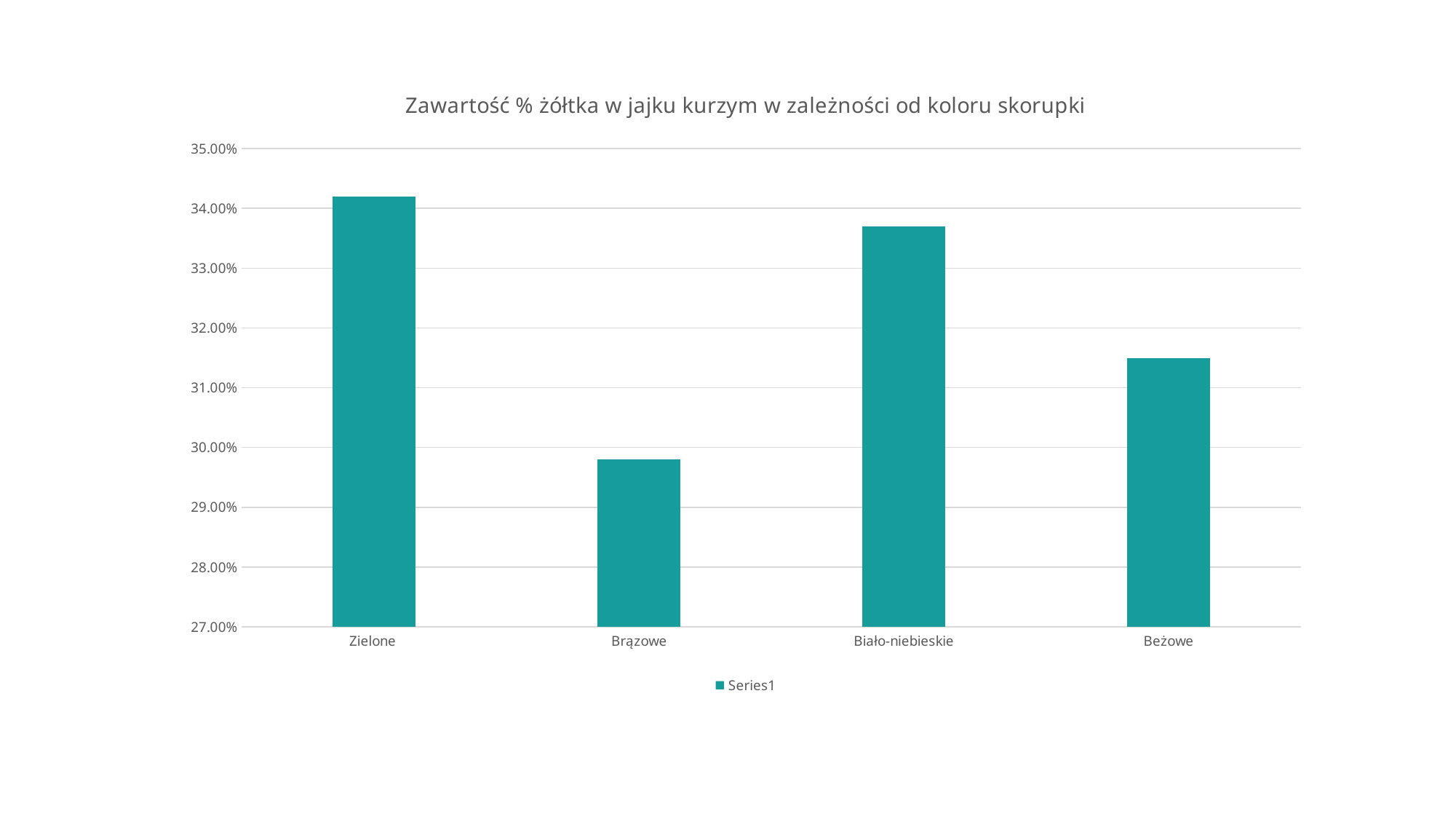
Is the value for Biało-niebieskie greater or less than 33.00%? greater Is the value for Zielone greater or less than 34.00%? greater Which category has the highest value? Zielone Which is larger, the value for Brązowe or the value for Beżowe? Beżowe What is the title of the chart? Zawartość % żółtka w jajku kurzym w zależności od koloru skorupki How many categories are shown on the x axis? 4 Which is larger, the value for Biało-niebieskie or the value for Beżowe? Biało-niebieskie Is the value for Brązowe greater or less than 30.00%? less What kind of chart is shown on the slide? bar chart Which category has the lowest value? Brązowe How many series does the legend list? 1